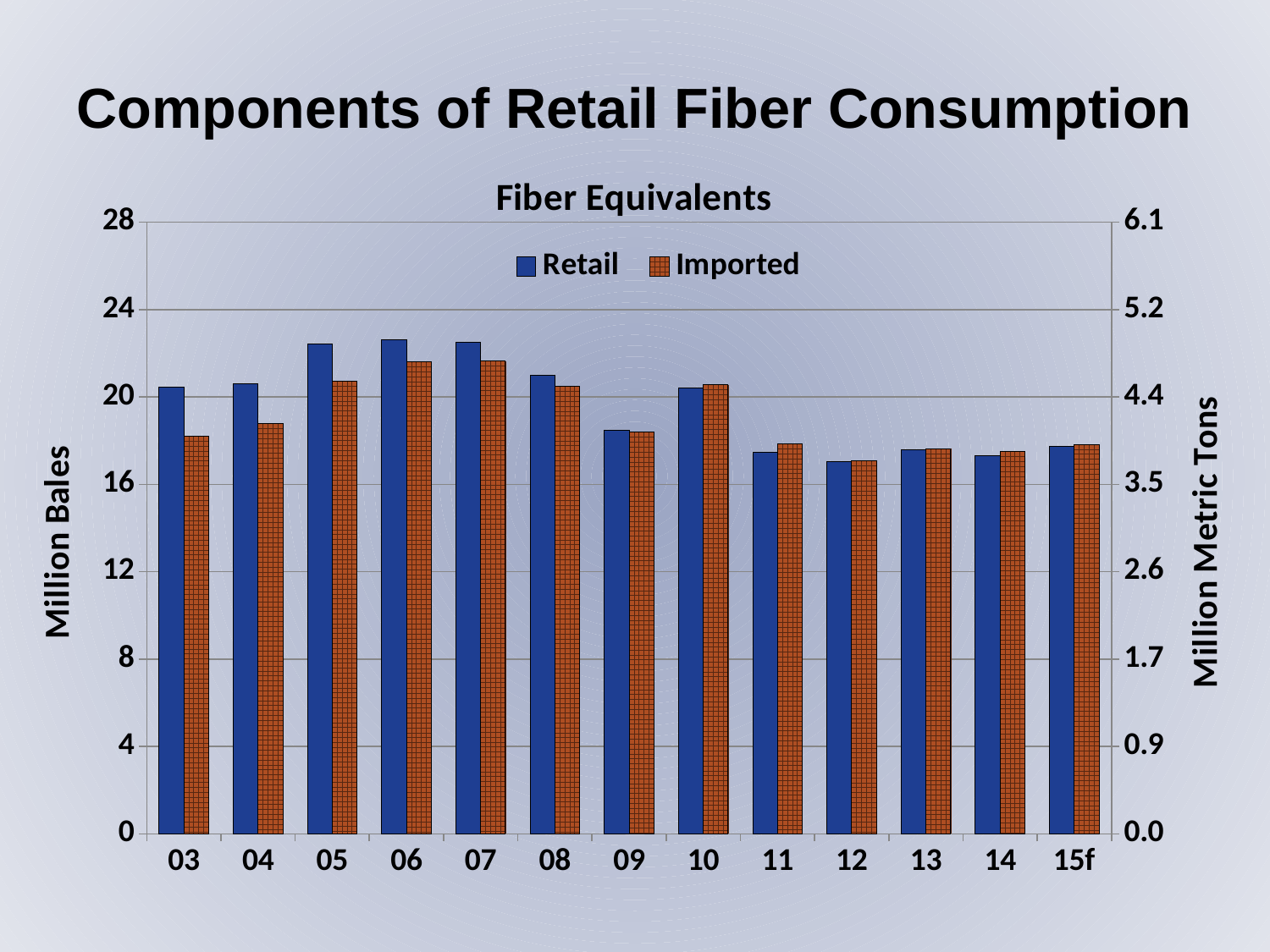
Which is larger, the Retail value for 05 or the Retail value for 09? 05 What is the title of the left vertical axis? Million Bales What kind of chart is shown on the slide? bar chart Is the Retail value for 09 greater or less than 16 million bales? greater Which is larger for 03, the Retail value or the Imported value? Retail How many years are shown along the x axis? 13 Is the Imported value for 06 greater or less than 20 million bales? greater Is the Retail value for 05 greater or less than 20 million bales? greater How many series does the legend list? 2 Which is larger for 11, the Retail value or the Imported value? Imported Do the Retail values rise or fall from 07 to 12? fall